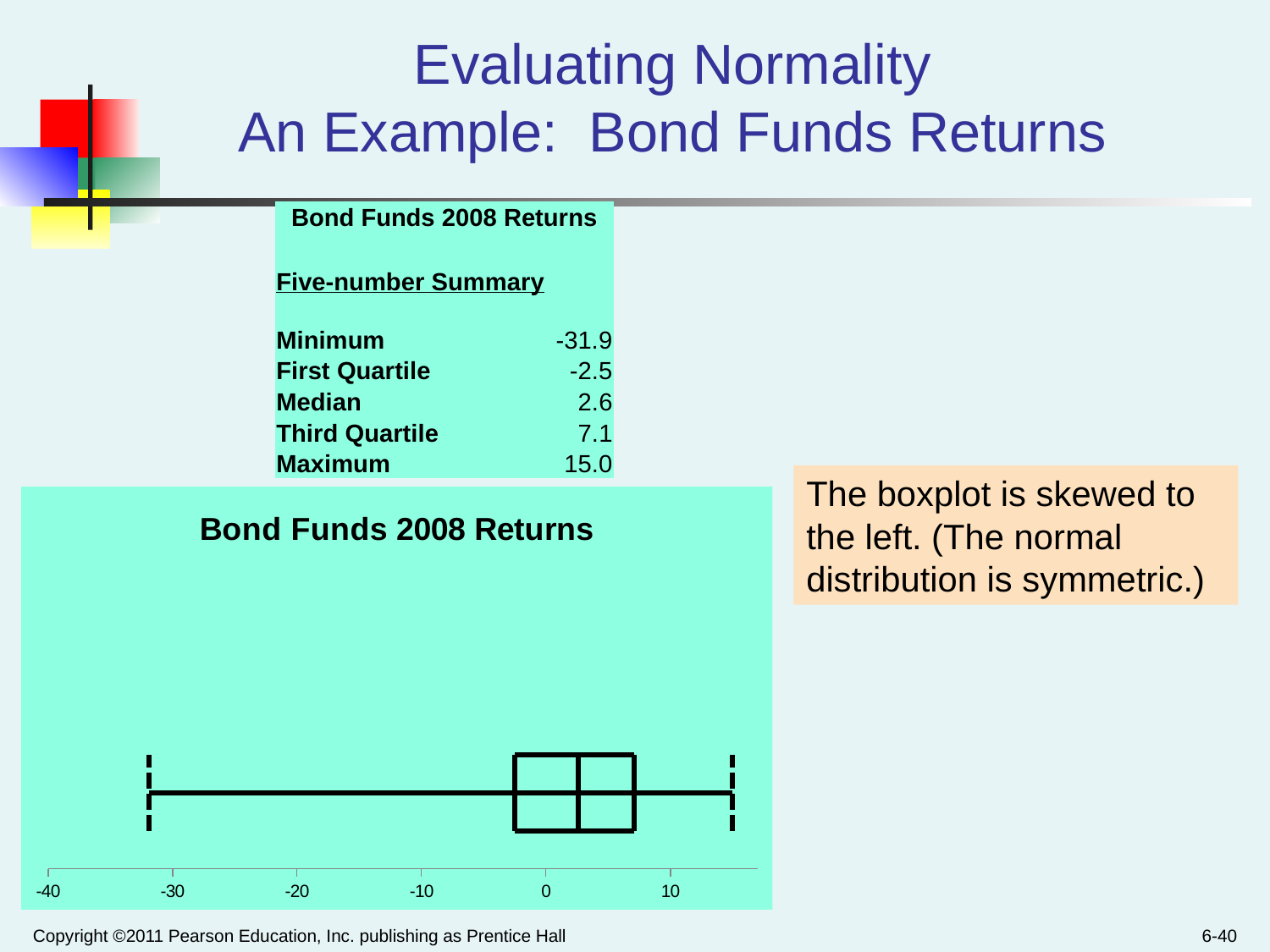
What is the title of the chart on the slide? Bond Funds 2008 Returns What is the first quartile of the Bond Funds 2008 Returns? -2.5 Which is larger, the median or the first quartile of the Bond Funds 2008 Returns? Median Is the right whisker of the boxplot greater or less than 10? greater What is the maximum value shown in the five-number summary for Bond Funds 2008 Returns? 15.0 What is the median of the Bond Funds 2008 Returns? 2.6 What is the third quartile of the Bond Funds 2008 Returns? 7.1 What is the difference between the maximum and the minimum of the Bond Funds 2008 Returns? 46.9 What is the minimum value shown in the five-number summary for Bond Funds 2008 Returns? -31.9 What kind of chart is shown on the slide? Boxplot Is the left whisker of the boxplot greater or less than -30? less What is the difference between the third quartile and the first quartile of the Bond Funds 2008 Returns? 9.6